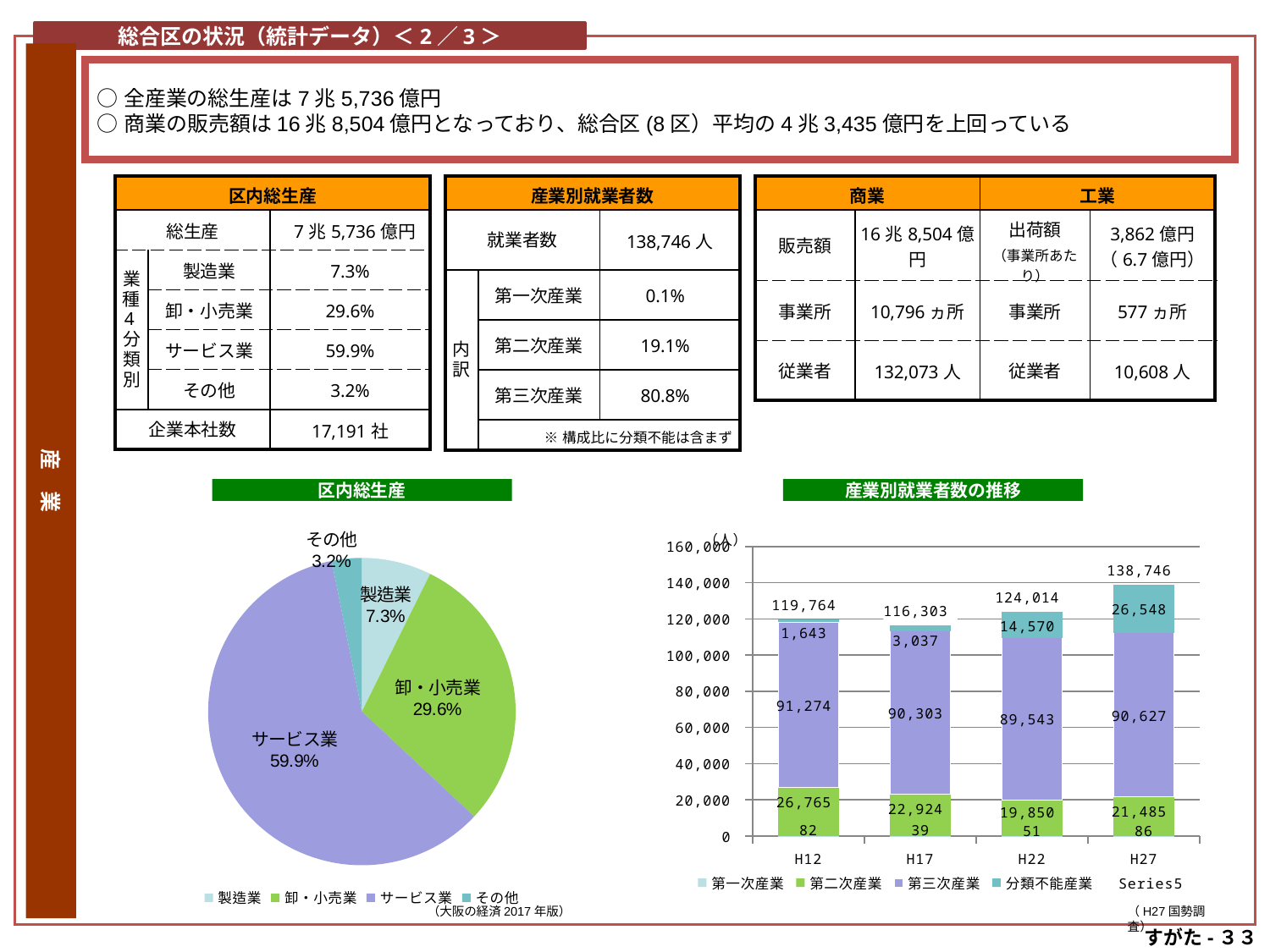
In the 産業別就業者数の推移 chart, what is the difference between the totals for H27 and H12? 18,982 What kind of chart is the 産業別就業者数の推移 chart? Stacked bar chart In the 区内総生産 pie chart, which category has the smallest share? その他 In the 区内総生産 pie chart, how many categories are shown? 4 In the 産業別就業者数の推移 chart, what is the value of 第三次産業 for H22? 89,543 In the 産業別就業者数の推移 chart, what is the total for H27? 138,746 In the 区内総生産 pie chart, which category has the largest share? サービス業 In the 産業別就業者数の推移 chart, which year has the lowest total? H17 How many entries does the legend of the 産業別就業者数の推移 chart list? 5 In the 区内総生産 pie chart, what share does サービス業 have? 59.9% In the 産業別就業者数の推移 chart, is the value of 分類不能産業 for H27 larger than for H22? Yes In the 区内総生産 pie chart, what is the difference between the shares of 卸・小売業 and 製造業? 22.3%